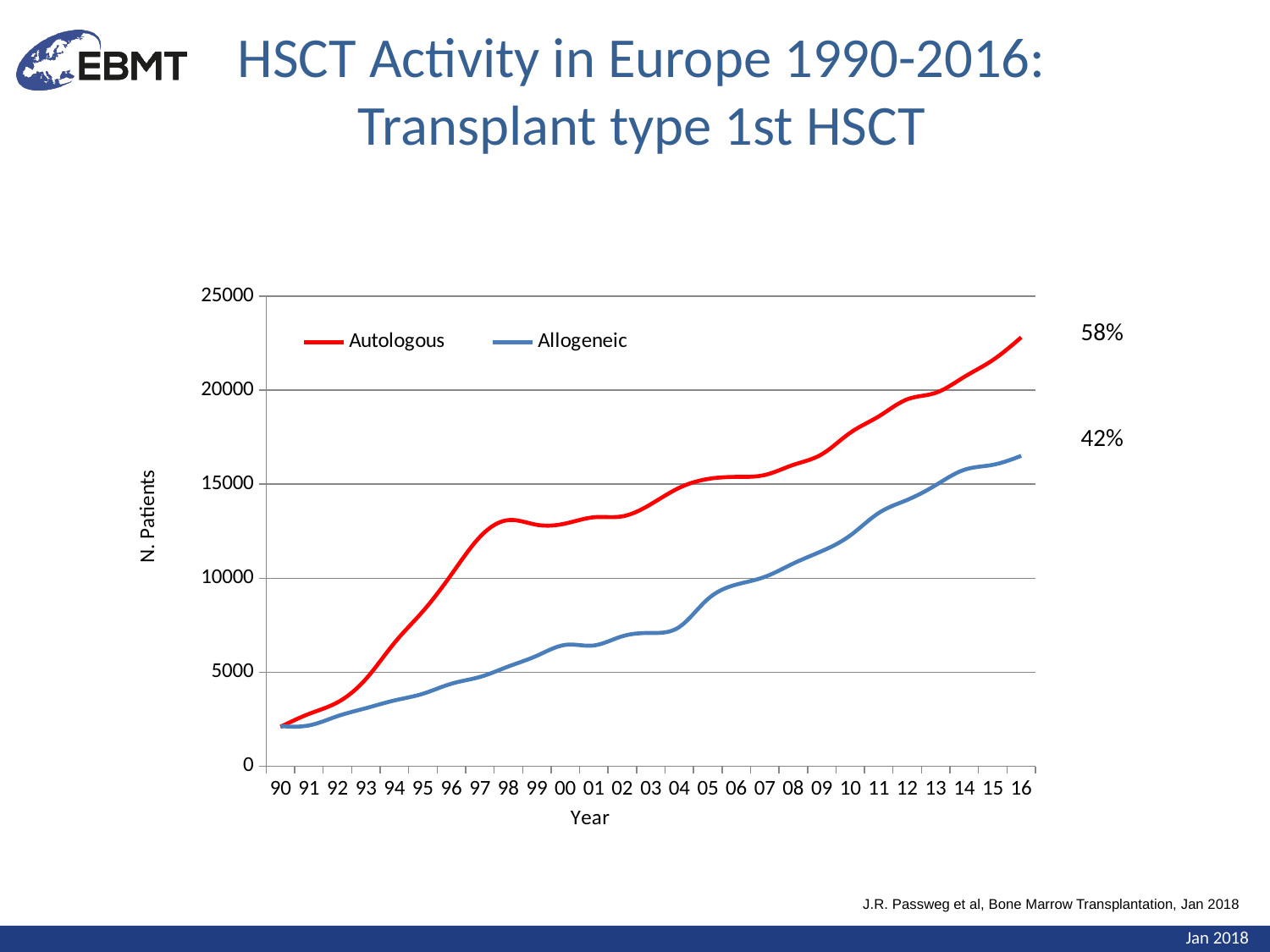
What are the two series named in the legend? Autologous and Allogeneic What kind of chart is shown on the slide? line chart How many series does the legend list? 2 Is the Allogeneic value for year 16 greater or less than 20000? less How many years are plotted along the x axis? 27 Does the Autologous line generally rise or fall from 90 to 16? rise Is the Autologous value for year 16 greater or less than 20000? greater What colour is the Autologous line? red What percentage label is shown at the end of the Allogeneic line? 42% Is the Allogeneic value for year 00 greater or less than 5000? greater What percentage label is shown at the end of the Autologous line? 58% In year 16, which series has the higher value, Autologous or Allogeneic? Autologous